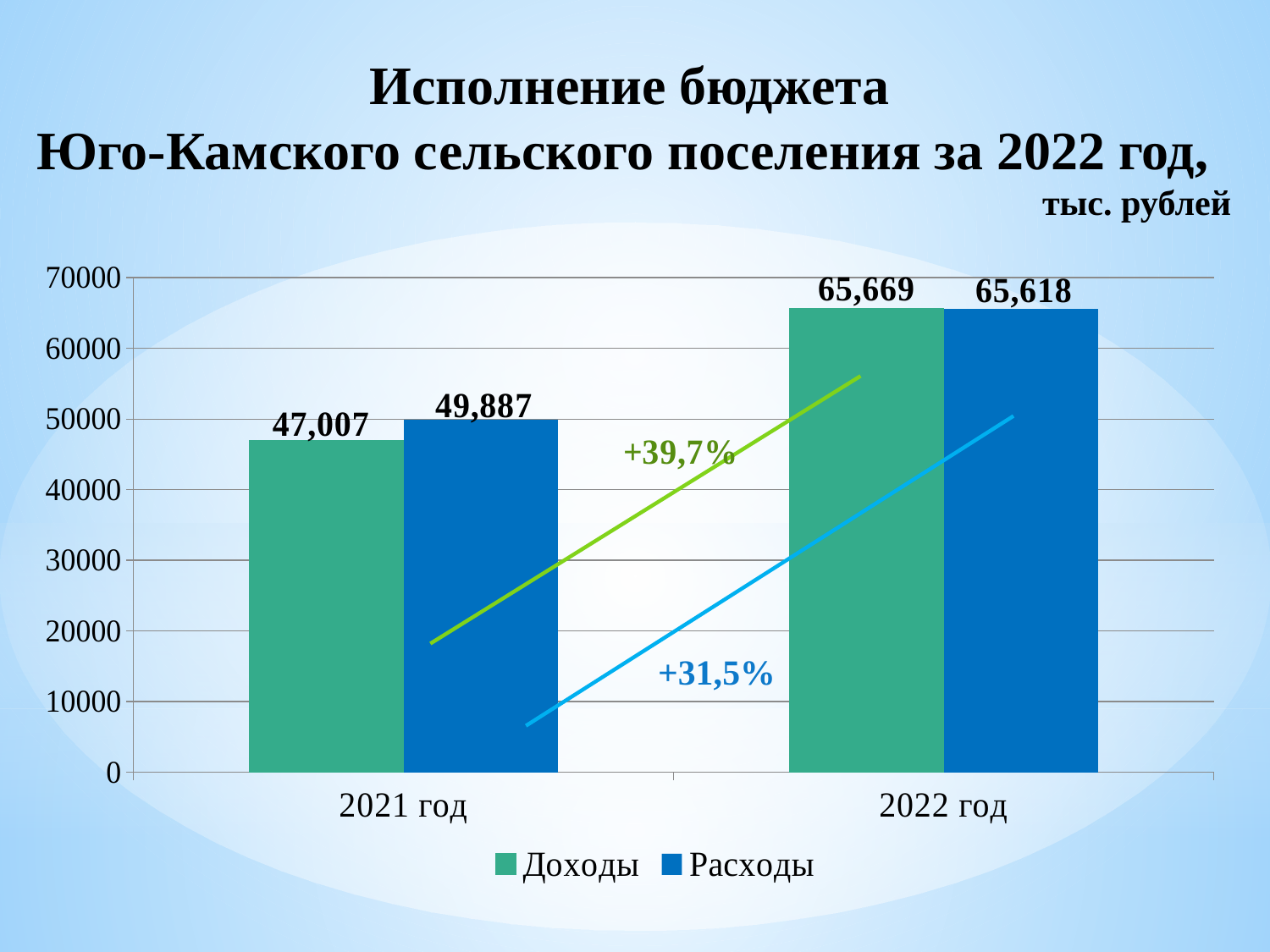
What is the value of Расходы for 2022 год? 65,618 What percentage growth is shown for Расходы between 2021 год and 2022 год? +31,5% What is the value of Доходы for 2022 год? 65,669 What is the value of Расходы for 2021 год? 49,887 In which year is Расходы lower? 2021 год By how much did Доходы increase from 2021 год to 2022 год? 18,662 What kind of chart is shown on the slide? Bar chart What is the difference between Расходы and Доходы in 2021 год? 2,880 What is the value of Доходы for 2021 год? 47,007 In which year is Доходы higher? 2022 год How many series does the legend list? 2 Which is larger in 2021 год, Доходы or Расходы? Расходы